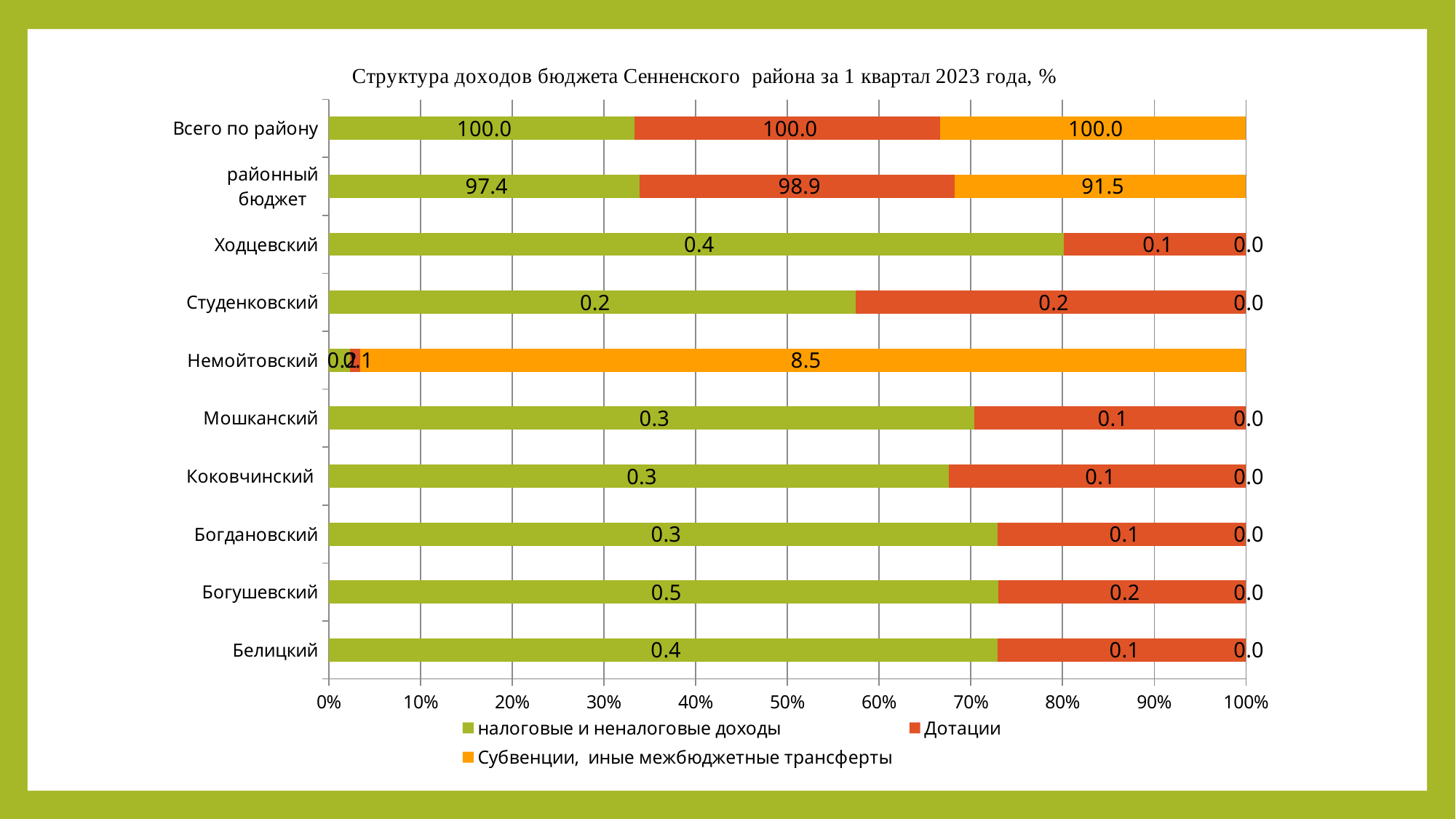
How many categories are shown on the vertical axis of the chart? 10 What is the title of the chart? Структура доходов бюджета Сенненского района за 1 квартал 2023 года, % What is the value of 'Дотации' for 'Студенковский'? 0.2 Which of the settlements (excluding 'Всего по району' and 'районный бюджет') has the highest value for 'Субвенции, иные межбюджетные трансферты'? Немойтовский What is the value of 'налоговые и неналоговые доходы' for 'районный бюджет'? 97.4 What is the difference between the 'Дотации' value and the 'Субвенции, иные межбюджетные трансферты' value for 'районный бюджет'? 7.4 What type of chart is shown on the slide? Stacked bar chart What is the value of 'налоговые и неналоговые доходы' for 'Богушевский'? 0.5 What is the value of 'Субвенции, иные межбюджетные трансферты' for 'Немойтовский'? 8.5 How many series does the legend list? 3 Which is larger: the 'налоговые и неналоговые доходы' value for 'Богушевский' or for 'Студенковский'? Богушевский What is the value of 'Дотации' for 'районный бюджет'? 98.9